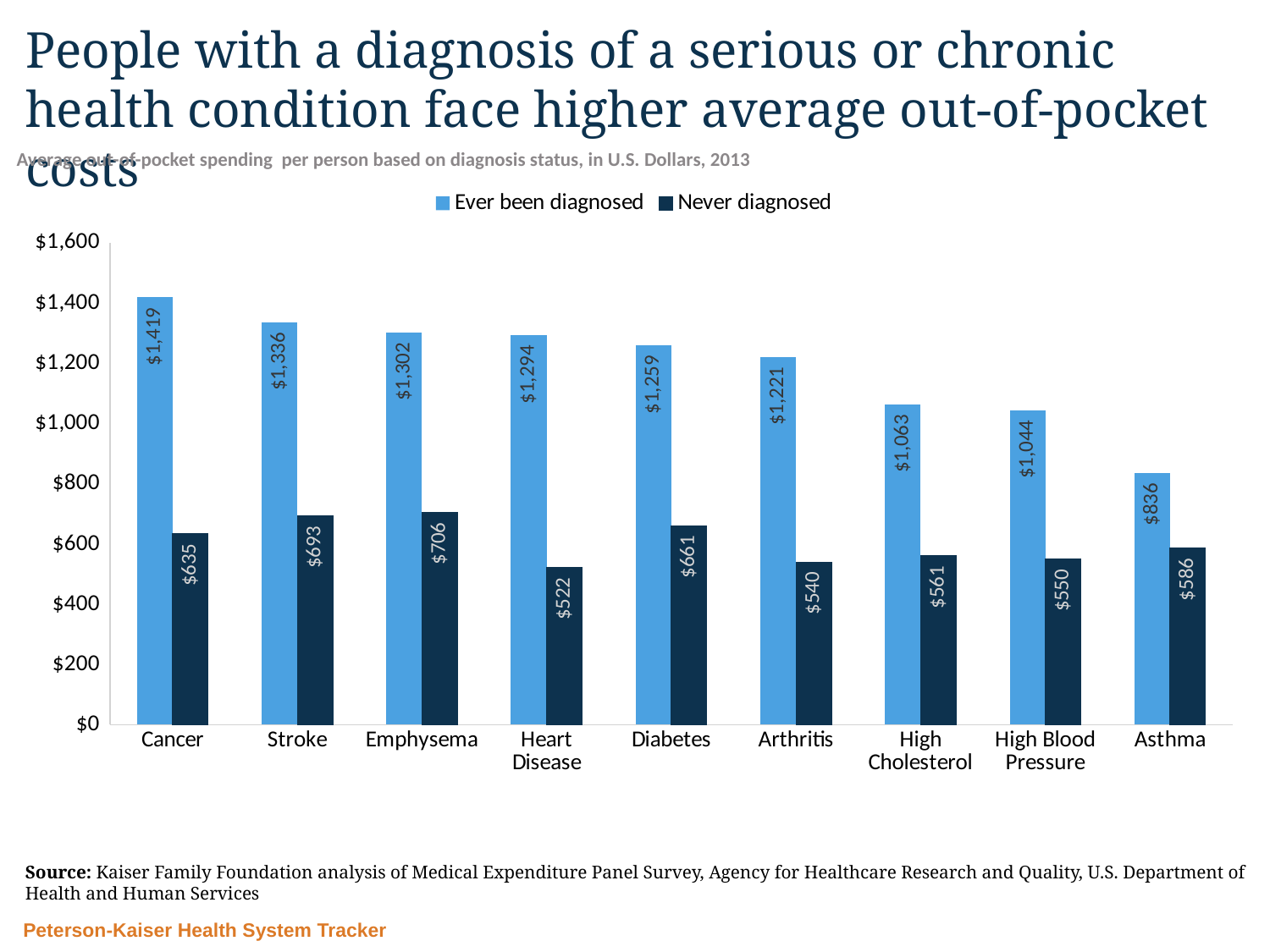
How many health conditions are shown on the x axis? 9 Which condition has the highest value in the 'Ever been diagnosed' series? Cancer What is the average out-of-pocket spending for people ever diagnosed with Cancer? $1,419 Is the 'Ever been diagnosed' value for High Cholesterol greater or less than $1,000? greater How many series does the legend list? 2 Which condition has the lowest value in the 'Never diagnosed' series? Heart Disease Which condition has the lowest value in the 'Ever been diagnosed' series? Asthma What is the difference between the 'Ever been diagnosed' and 'Never diagnosed' values for Diabetes? $598 What is the value for the 'Never diagnosed' series for Emphysema? $706 What is the average out-of-pocket spending for people never diagnosed with Heart Disease? $522 What kind of chart is shown on the slide? Bar chart Which is larger: the 'Never diagnosed' value for Stroke or for Arthritis? Stroke